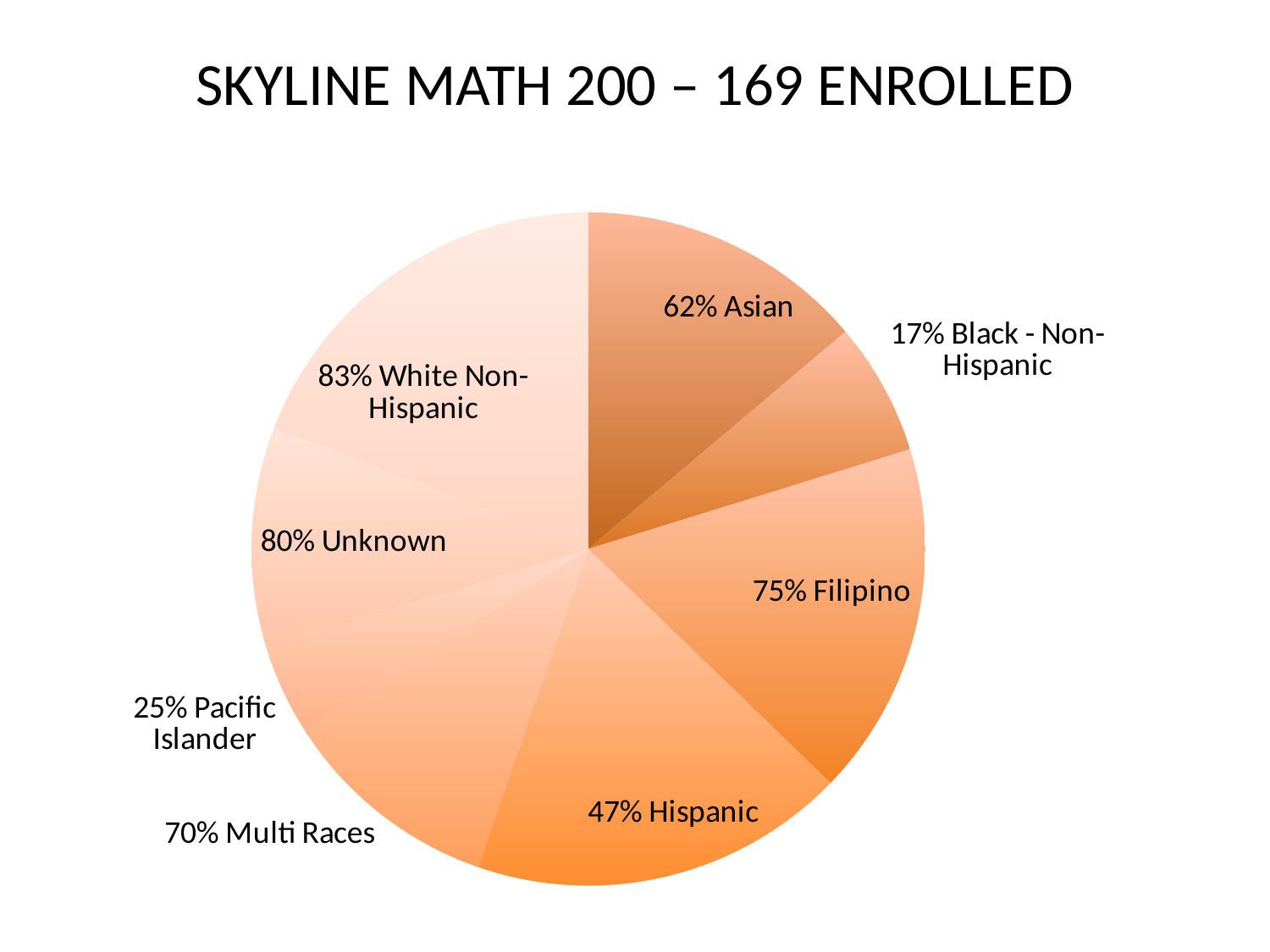
What value is shown for Hispanic on the pie chart? 47% Which category has the highest printed value on the pie chart? White Non-Hispanic What is the difference between the printed values for White Non-Hispanic and Black - Non-Hispanic? 66 percentage points What value is shown for Filipino on the pie chart? 75% What is the title of the slide? SKYLINE MATH 200 – 169 ENROLLED Which has the larger printed value, Filipino or Hispanic? Filipino What value is shown for Unknown on the pie chart? 80% What value is shown for Asian on the pie chart? 62% What value is shown for Pacific Islander on the pie chart? 25% What kind of chart is shown on the slide? Pie chart Which category has the lowest printed value on the pie chart? Black - Non-Hispanic How many categories are shown on the pie chart? 8